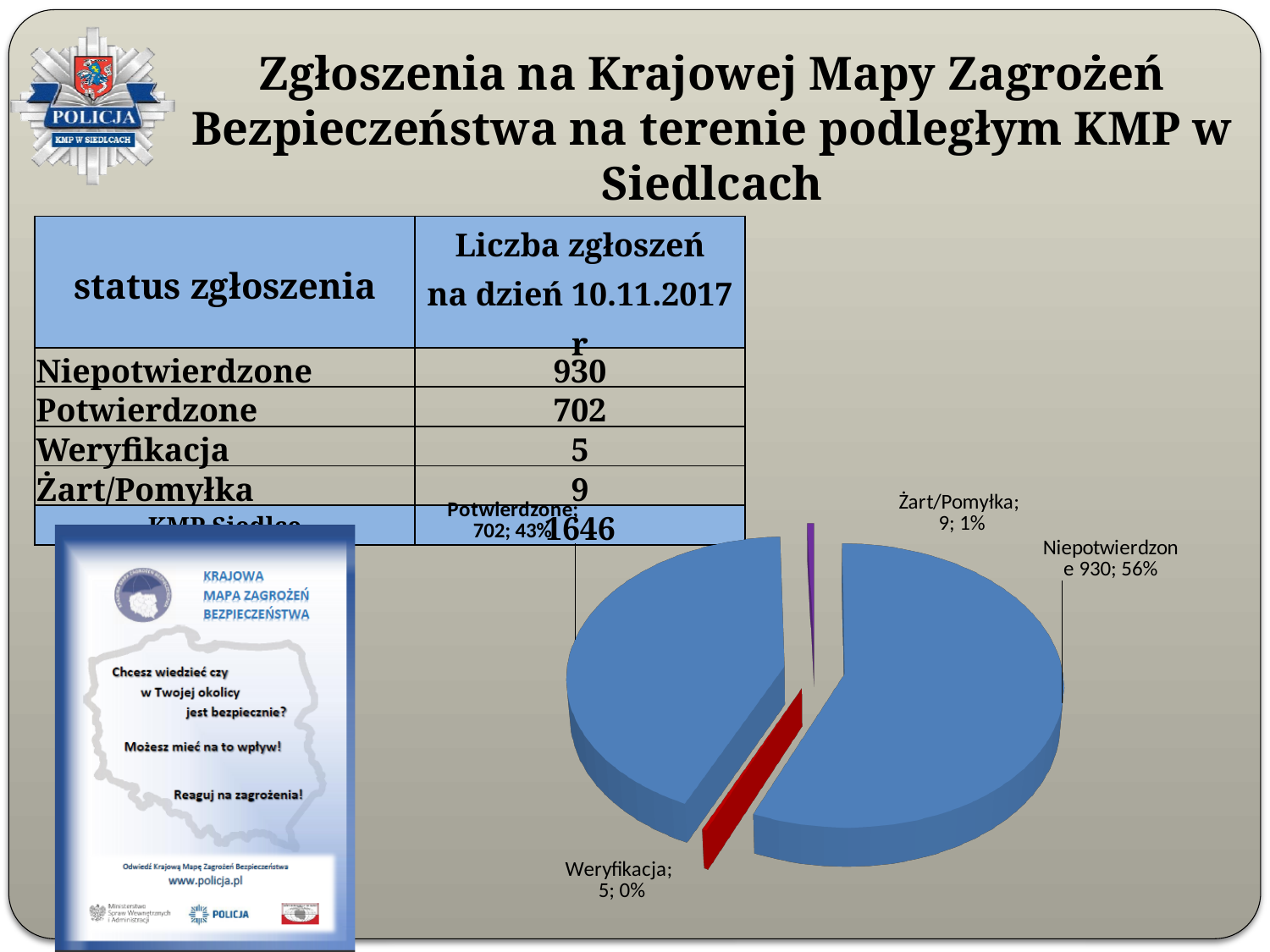
What share of the pie does Potwierdzone represent? 43% What share of the pie does Niepotwierdzone represent? 56% How many slices does the pie chart have? 4 What value is shown for Żart/Pomyłka in the pie chart? 9 What is the difference between the values for Niepotwierdzone and Potwierdzone in the pie chart? 228 Which slice of the pie chart is the smallest? Weryfikacja What value is shown for Weryfikacja in the pie chart? 5 Which is larger in the pie chart, Żart/Pomyłka or Weryfikacja? Żart/Pomyłka What kind of chart is shown on the slide? pie chart Which slice of the pie chart is the largest? Niepotwierdzone What value is shown for Potwierdzone in the pie chart? 702 What value is shown for Niepotwierdzone in the pie chart? 930